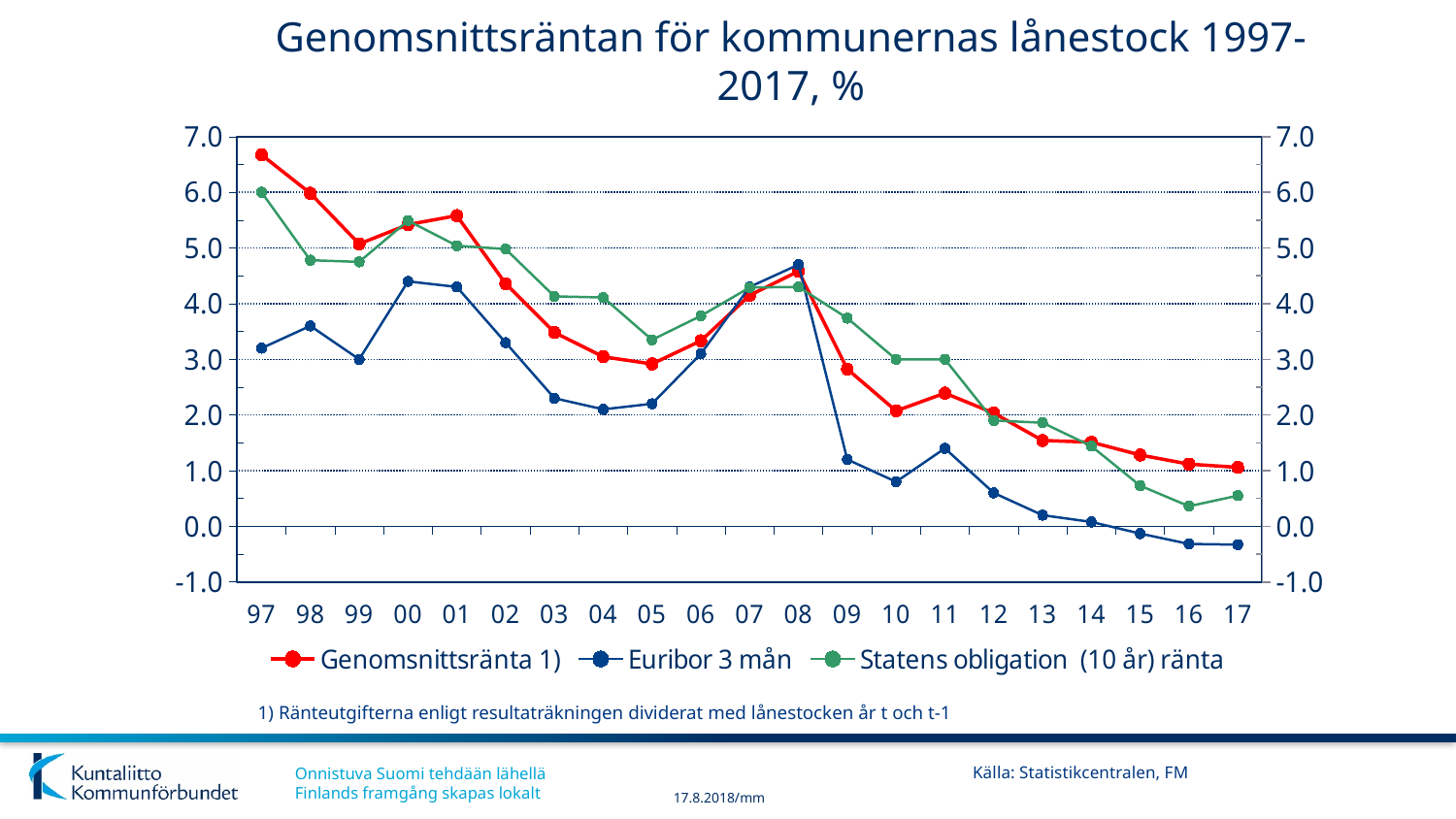
In which year is the Statens obligation (10 år) ränta series at its highest? 97 In which year is the Genomsnittsränta series at its highest? 97 How many years are plotted along the x axis? 21 What kind of chart is shown on the slide? Line chart In 97, which is larger: Genomsnittsränta or Euribor 3 mån? Genomsnittsränta In which year is the Euribor 3 mån series at its highest? 08 Is the value for Statens obligation (10 år) ränta in 15 greater or less than 1.0? less How many series does the legend list? 3 Which series is drawn in red? Genomsnittsränta 1) Is the value for Genomsnittsränta in 97 greater or less than 6.0? greater What is the title of the chart? Genomsnittsräntan för kommunernas lånestock 1997-2017, % Is the value for Euribor 3 mån in 16 greater or less than 0.0? less